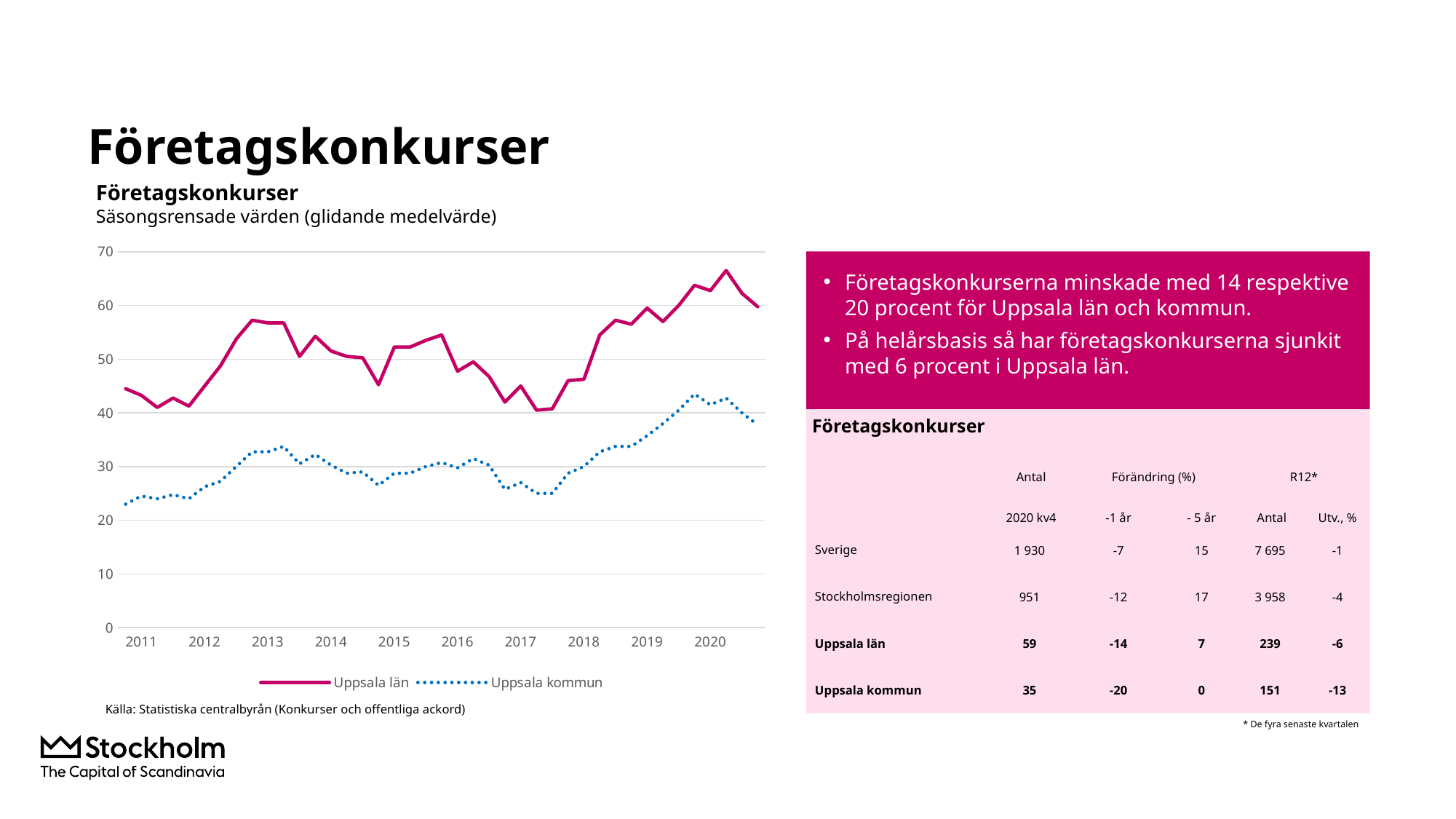
Is the highest value reached by Uppsala kommun in 2020 greater or less than 40? greater What are the two series named in the chart legend? Uppsala län and Uppsala kommun Which series has the higher values throughout the chart, Uppsala län or Uppsala kommun? Uppsala län How many year labels are shown on the x axis of the chart? 10 What is the subtitle printed under the chart title "Företagskonkurser"? Säsongsrensade värden (glidande medelvärde) Is the value for Uppsala kommun at the start of 2011 greater or less than 30? less What kind of chart is shown on the slide? Line chart Does the Uppsala kommun series overall rise or fall from 2011 to 2020? Rise Does the Uppsala län series rise or fall from 2017 to 2019? Rise Is the value for Uppsala län at the start of 2011 greater or less than 40? greater How many series does the chart legend list? 2